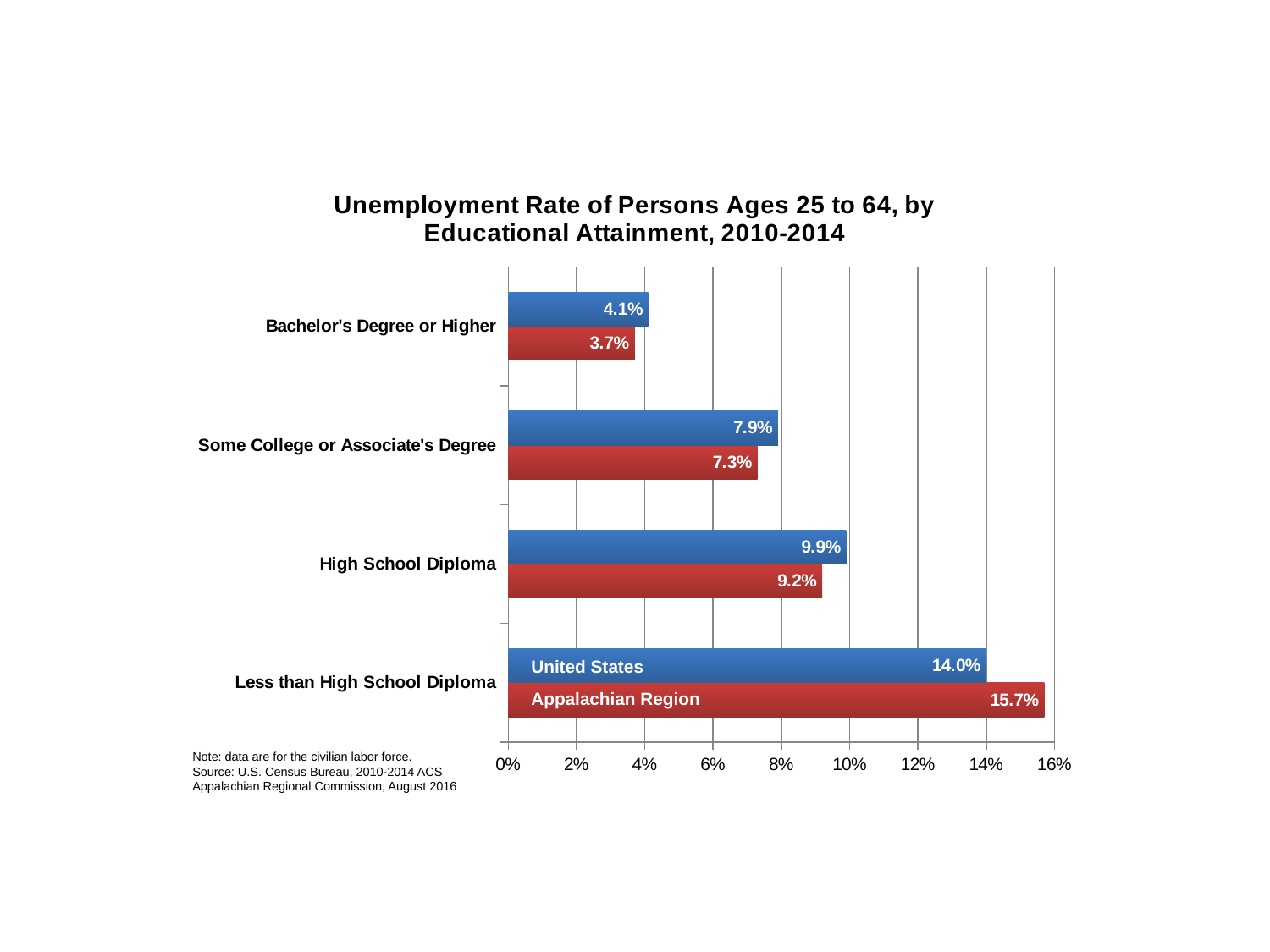
What is the Appalachian Region unemployment rate for persons with a High School Diploma? 9.2% How many series does the chart show? 2 Which educational attainment category has the lowest unemployment rate for the Appalachian Region? Bachelor's Degree or Higher What is the difference between the United States and Appalachian Region unemployment rates for Some College or Associate's Degree? 0.6% Is the Appalachian Region unemployment rate for Less than High School Diploma greater or less than 14%? greater Which educational attainment category has the highest unemployment rate for the United States? Less than High School Diploma How many educational attainment categories are shown in the chart? 4 For High School Diploma, which is larger: the United States rate or the Appalachian Region rate? United States What is the unemployment rate for the United States among persons with a Bachelor's Degree or Higher? 4.1% What type of chart is shown on the slide? Bar chart What is the unemployment rate for the Appalachian Region among persons with Less than High School Diploma? 15.7% What is the difference between the Appalachian Region and United States unemployment rates for Less than High School Diploma? 1.7%